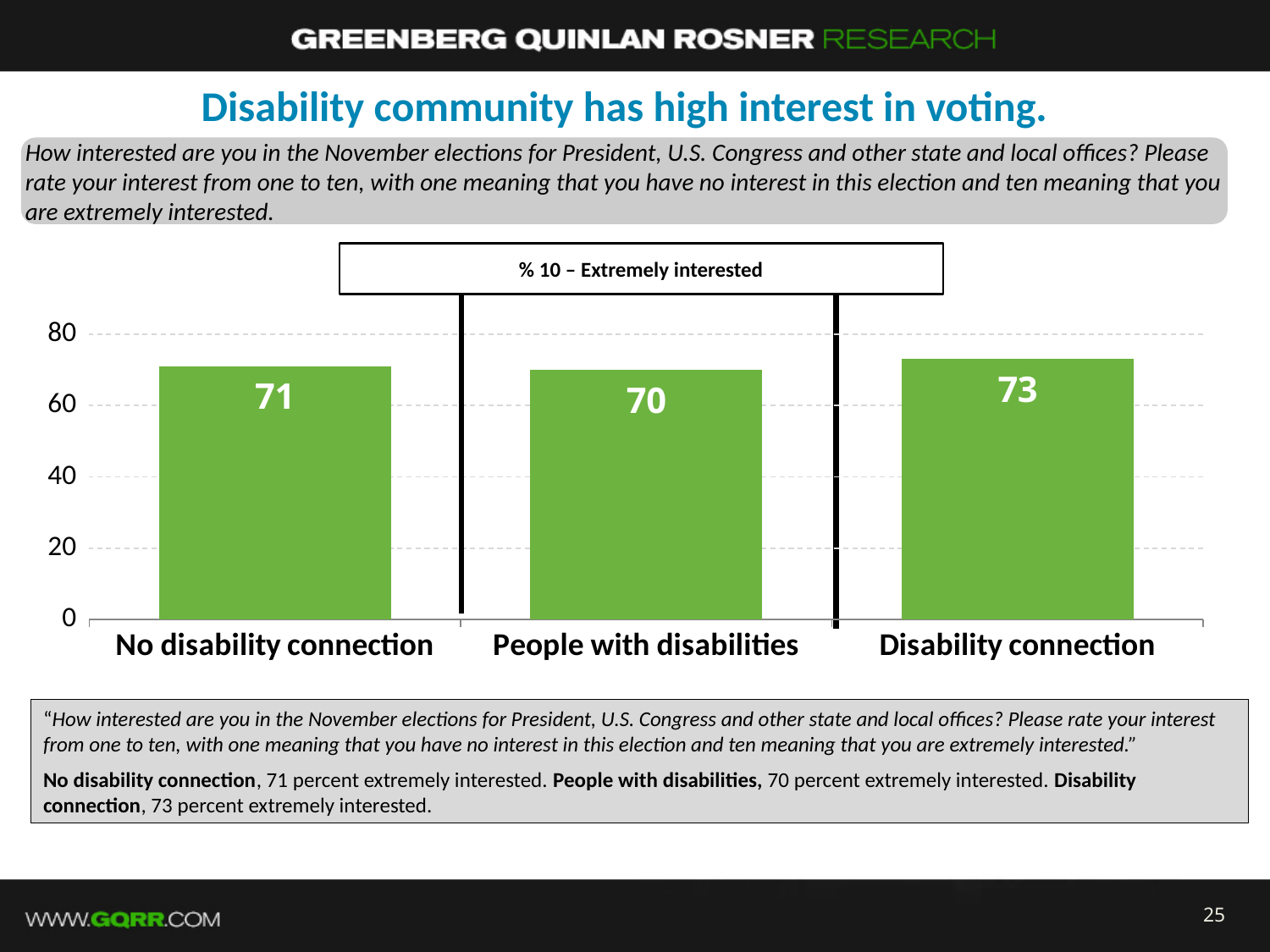
How many categories are shown in the chart? 3 What is the difference between the values for Disability connection and People with disabilities? 3 What is the value for Disability connection? 73 Is the value for Disability connection greater or less than 80? less Which category has the highest value? Disability connection Which category has the lowest value? People with disabilities What is the value for People with disabilities? 70 What is the label in the box above the chart? % 10 – Extremely interested What kind of chart is shown on the slide? bar chart What is the value for No disability connection? 71 Which is larger, the value for No disability connection or the value for People with disabilities? No disability connection What is the difference between the values for Disability connection and No disability connection? 2